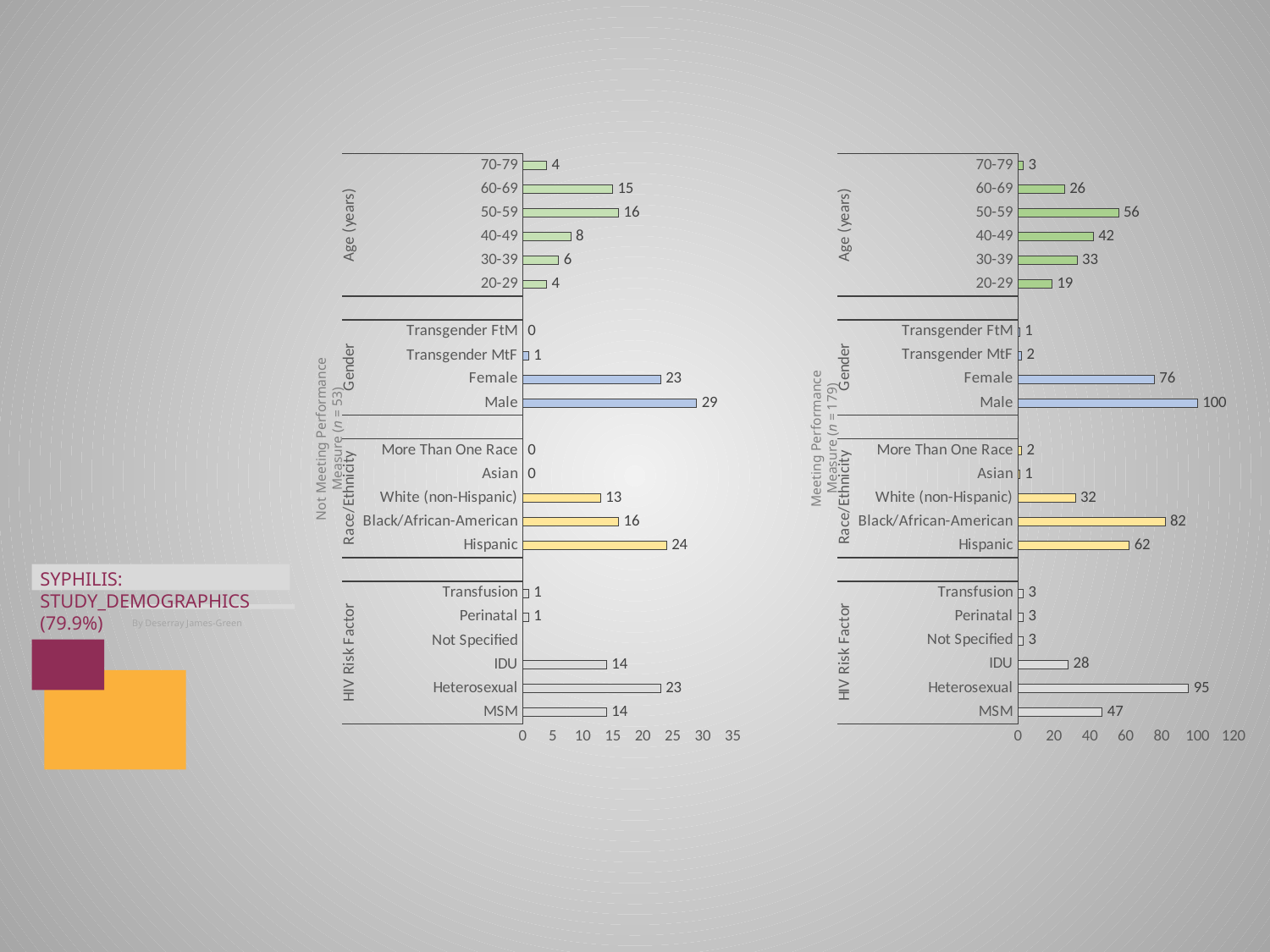
In the right chart (Meeting Performance Measure), which is larger, the value for IDU or the value for MSM? MSM What is the sample size (n) stated in the axis title of the right chart? 179 In the right chart (Meeting Performance Measure), what is the value for Black/African-American? 82 In the right chart (Meeting Performance Measure), what is the difference between the Male and Female values? 24 In the right chart (Meeting Performance Measure), which age group has the highest value? 50-59 In the left chart (Not Meeting Performance Measure), which HIV risk factor has the highest value? Heterosexual In the left chart (Not Meeting Performance Measure), what is the difference between the Hispanic and White (non-Hispanic) values? 11 How many age groups are shown in the left chart (Not Meeting Performance Measure)? 6 What type of chart is the right chart (Meeting Performance Measure)? bar chart In the left chart (Not Meeting Performance Measure), what is the value for Male? 29 In the left chart (Not Meeting Performance Measure), is the value for Female greater or less than 20? greater In the right chart (Meeting Performance Measure), which age group has the lowest value? 70-79